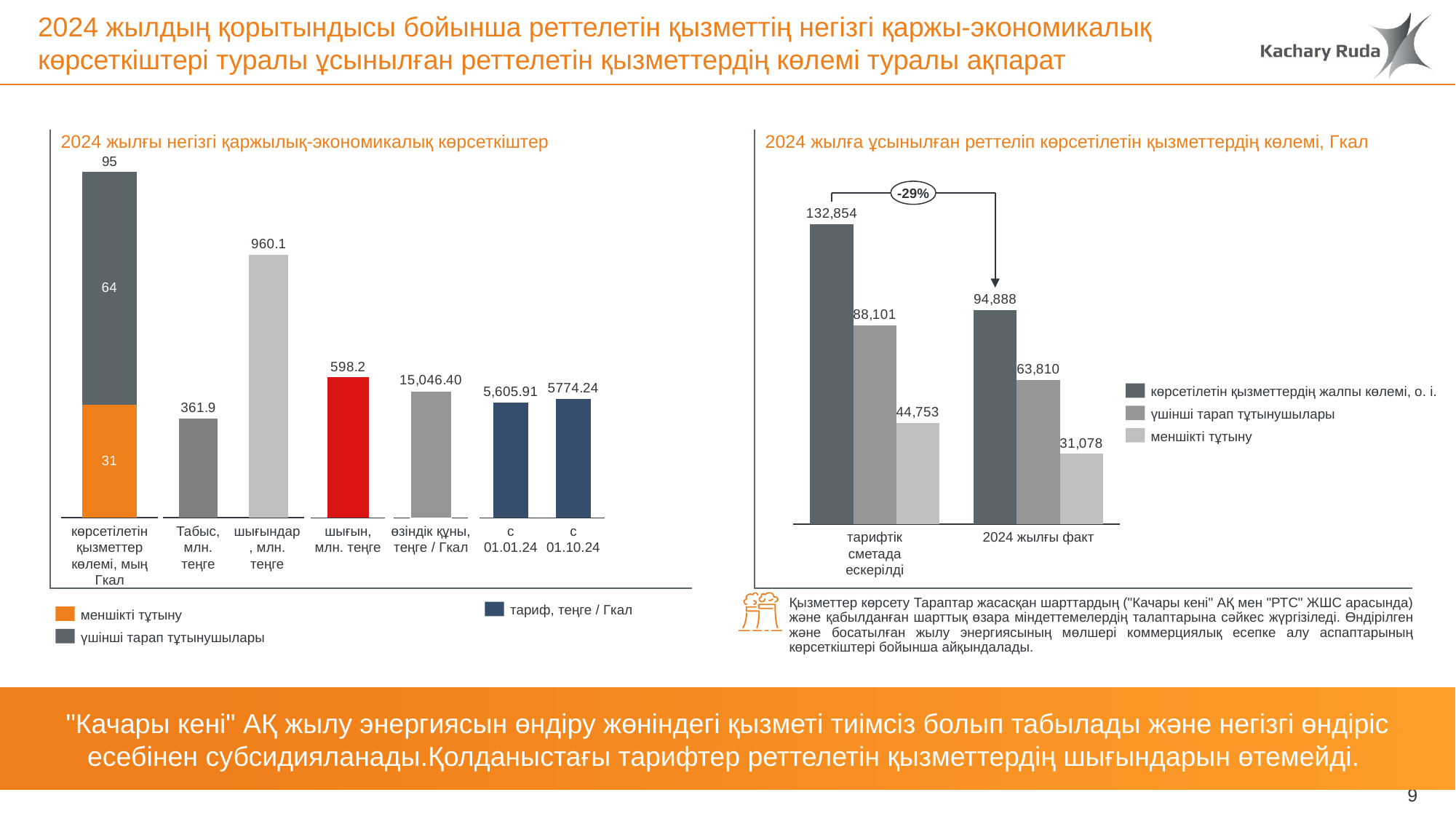
How many series does the legend of the right chart list? 3 On the left chart, what is the total of the stacked bar for 'көрсетілетін қызметтер көлемі, мың Гкал'? 95 On the right chart, what is the value of 'үшінші тарап тұтынушылары' for '2024 жылғы факт'? 63,810 On the right chart, what is the value of 'меншікті тұтыну' for '2024 жылғы факт'? 31,078 On the left chart, what is the value of 'меншікті тұтыну' in the stacked bar for 'көрсетілетін қызметтер көлемі, мың Гкал'? 31 On the right chart, what is the difference between the total volume for 'тарифтік сметада ескерілді' and for '2024 жылғы факт'? 37,966 On the left chart, what is the value labelled for 'Табыс, млн. теңге'? 361.9 On the right chart, what is the total volume of services (көрсетілетін қызметтердің жалпы көлемі) for 'тарифтік сметада ескерілді'? 132,854 On the left chart, what is the difference between 'шығындар, млн. теңге' (960.1) and 'Табыс, млн. теңге' (361.9)? 598.2 On the left chart, which is larger: the tariff on 01.01.24 or the tariff on 01.10.24? 01.10.24 On the right chart, what percentage change is shown in the annotation between the two total-volume bars? -29% What type of chart is the right chart? Bar chart